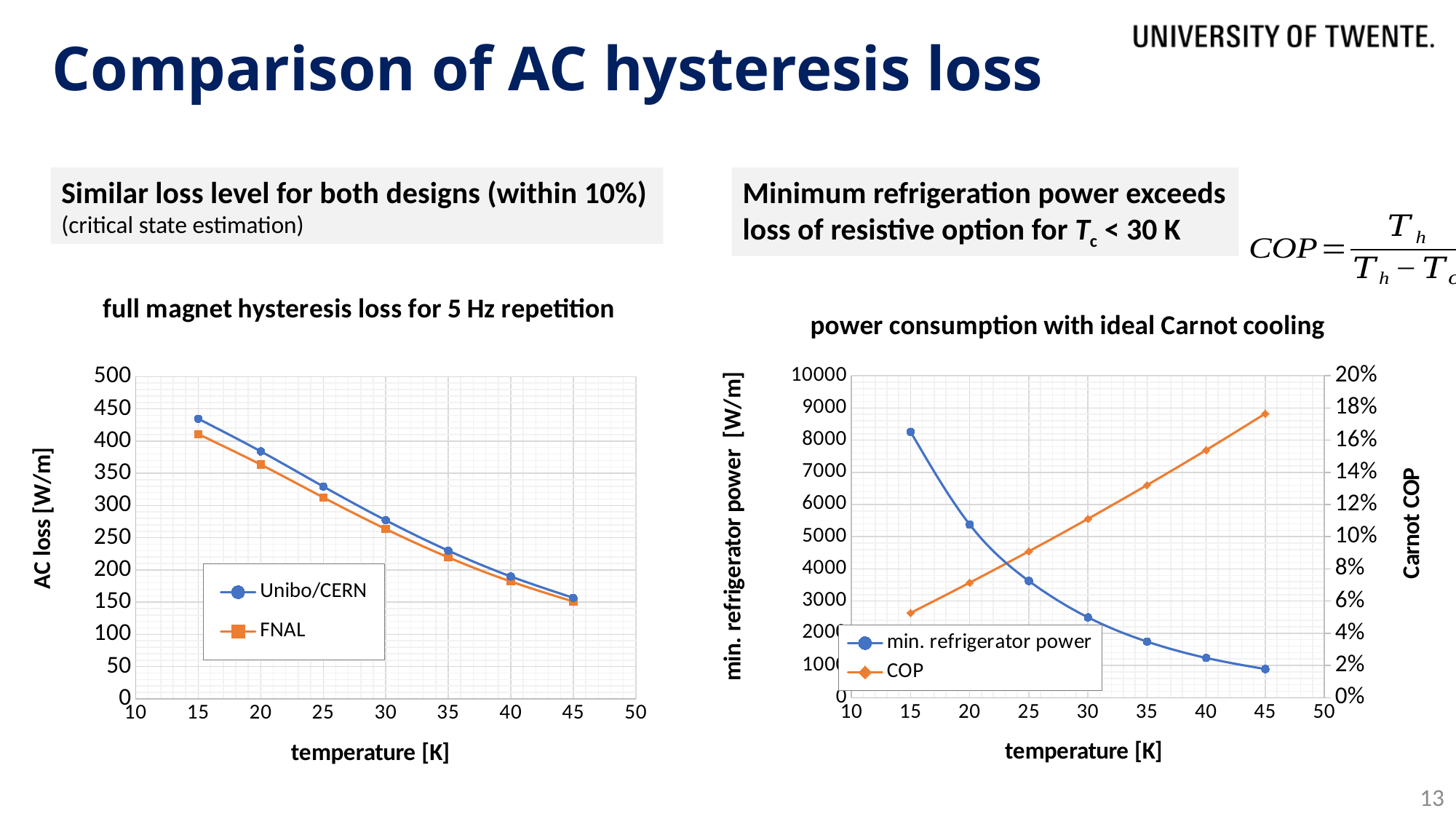
In the chart titled 'full magnet hysteresis loss for 5 Hz repetition', what kind of chart is shown? line chart In the chart titled 'full magnet hysteresis loss for 5 Hz repetition', which series has the higher AC loss at 20 K, Unibo/CERN or FNAL? Unibo/CERN In the chart titled 'power consumption with ideal Carnot cooling', how many series does the legend list? 2 In the chart titled 'power consumption with ideal Carnot cooling', does the COP series rise or fall as temperature increases? rise In the chart titled 'full magnet hysteresis loss for 5 Hz repetition', how many data points does the Unibo/CERN series have? 7 In the chart titled 'full magnet hysteresis loss for 5 Hz repetition', is the Unibo/CERN value at 45 K greater or less than 200? less In the chart titled 'power consumption with ideal Carnot cooling', what is the label of the right-hand vertical axis? Carnot COP In the chart titled 'full magnet hysteresis loss for 5 Hz repetition', how many series does the legend list? 2 In the chart titled 'power consumption with ideal Carnot cooling', does the min. refrigerator power series rise or fall as temperature increases? fall In the chart titled 'power consumption with ideal Carnot cooling', is the COP value at 45 K greater or less than 16%? greater In the chart titled 'full magnet hysteresis loss for 5 Hz repetition', do the AC loss values rise or fall as temperature increases? fall In the chart titled 'full magnet hysteresis loss for 5 Hz repetition', is the Unibo/CERN value at 15 K greater or less than 400? greater